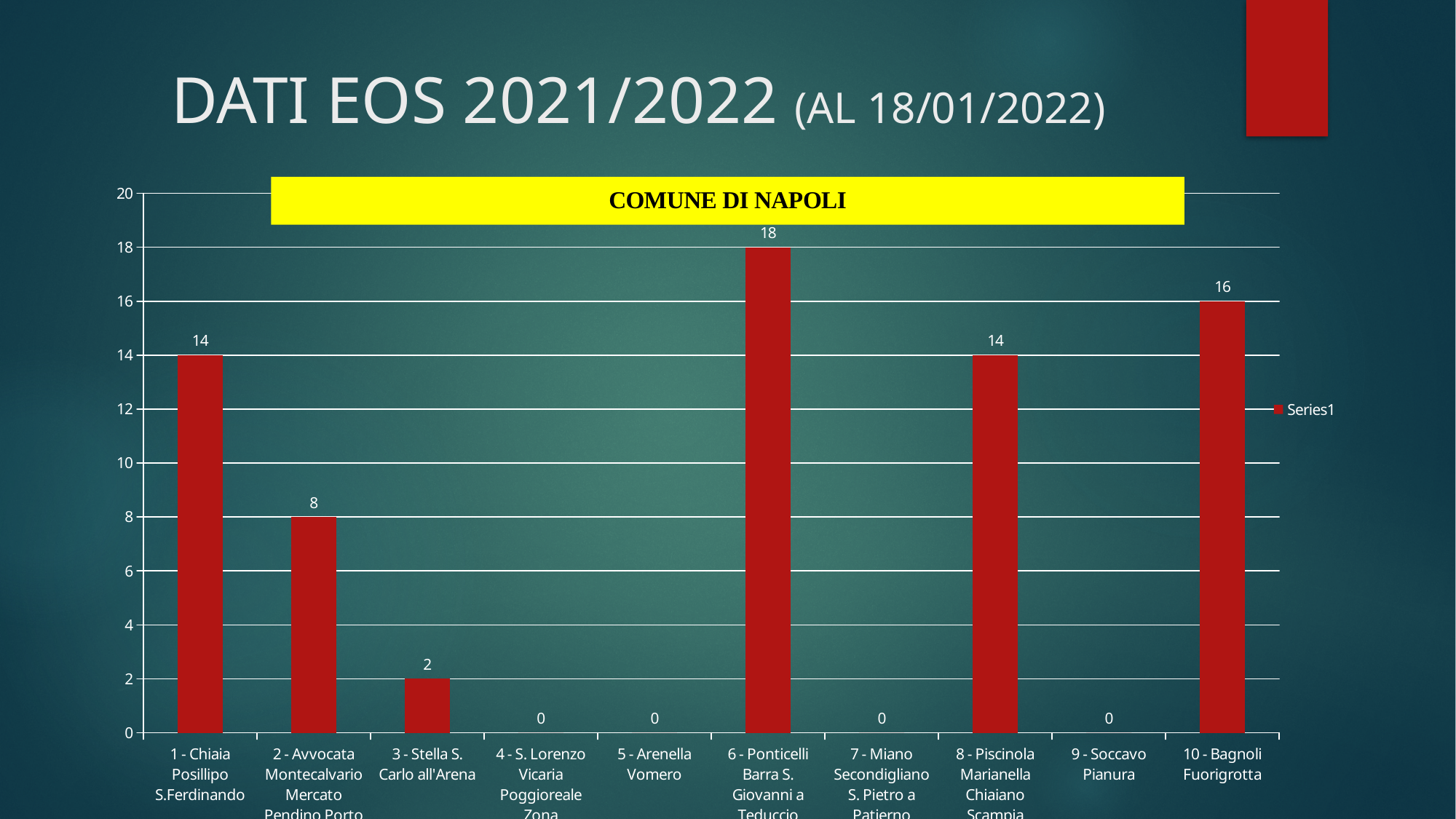
What text appears in the yellow box above the chart? COMUNE DI NAPOLI How many series does the legend list? 1 Which is larger, the value for 1 - Chiaia Posillipo S.Ferdinando or the value for 2 - Avvocata Montecalvario Mercato Pendino Porto? 1 - Chiaia Posillipo S.Ferdinando What kind of chart is shown on the slide? Bar chart Which category has the highest value? 6 - Ponticelli Barra S. Giovanni a Teduccio What is the value for 2 - Avvocata Montecalvario Mercato Pendino Porto? 8 How many categories have a value of 0? 4 What is the difference between the values for 6 - Ponticelli Barra S. Giovanni a Teduccio and 10 - Bagnoli Fuorigrotta? 2 What is the value for 3 - Stella S. Carlo all'Arena? 2 What is the value for 6 - Ponticelli Barra S. Giovanni a Teduccio? 18 What is the value for 10 - Bagnoli Fuorigrotta? 16 How many categories are shown on the x axis? 10